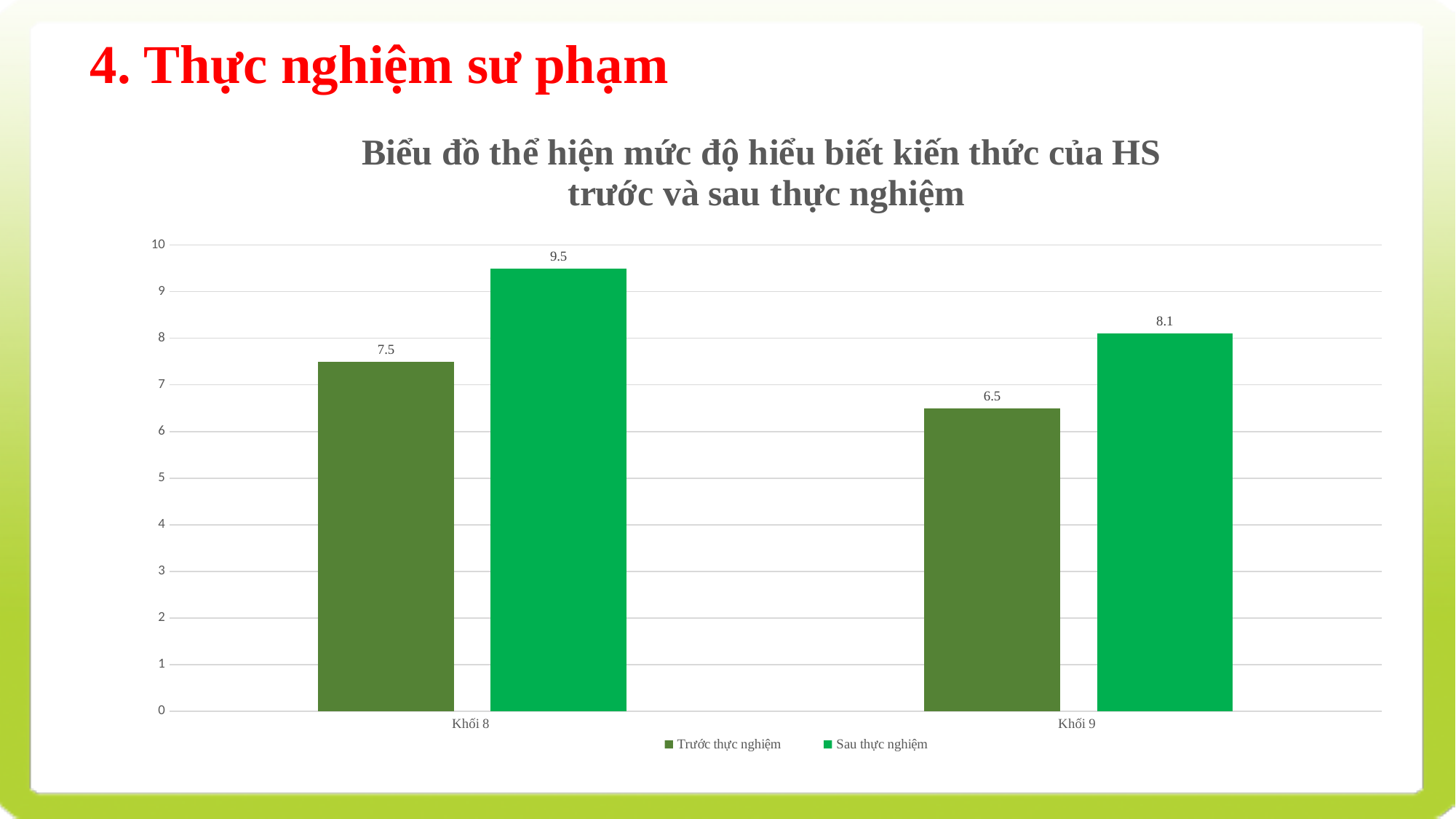
How many categories are shown on the x axis? 2 Which is larger: the Trước thực nghiệm value for Khối 8 or the Trước thực nghiệm value for Khối 9? Khối 8 What is the value for Khối 8 in the Sau thực nghiệm series? 9.5 What is the difference between the Sau thực nghiệm and Trước thực nghiệm values for Khối 9? 1.6 What kind of chart is shown on the slide? Bar chart How many series does the legend list? 2 What is the value for Khối 9 in the Sau thực nghiệm series? 8.1 Which category has the lowest Trước thực nghiệm value? Khối 9 What is the value for Khối 8 in the Trước thực nghiệm series? 7.5 What is the value for Khối 9 in the Trước thực nghiệm series? 6.5 What is the difference between the Sau thực nghiệm and Trước thực nghiệm values for Khối 8? 2 Which category has the highest Sau thực nghiệm value? Khối 8